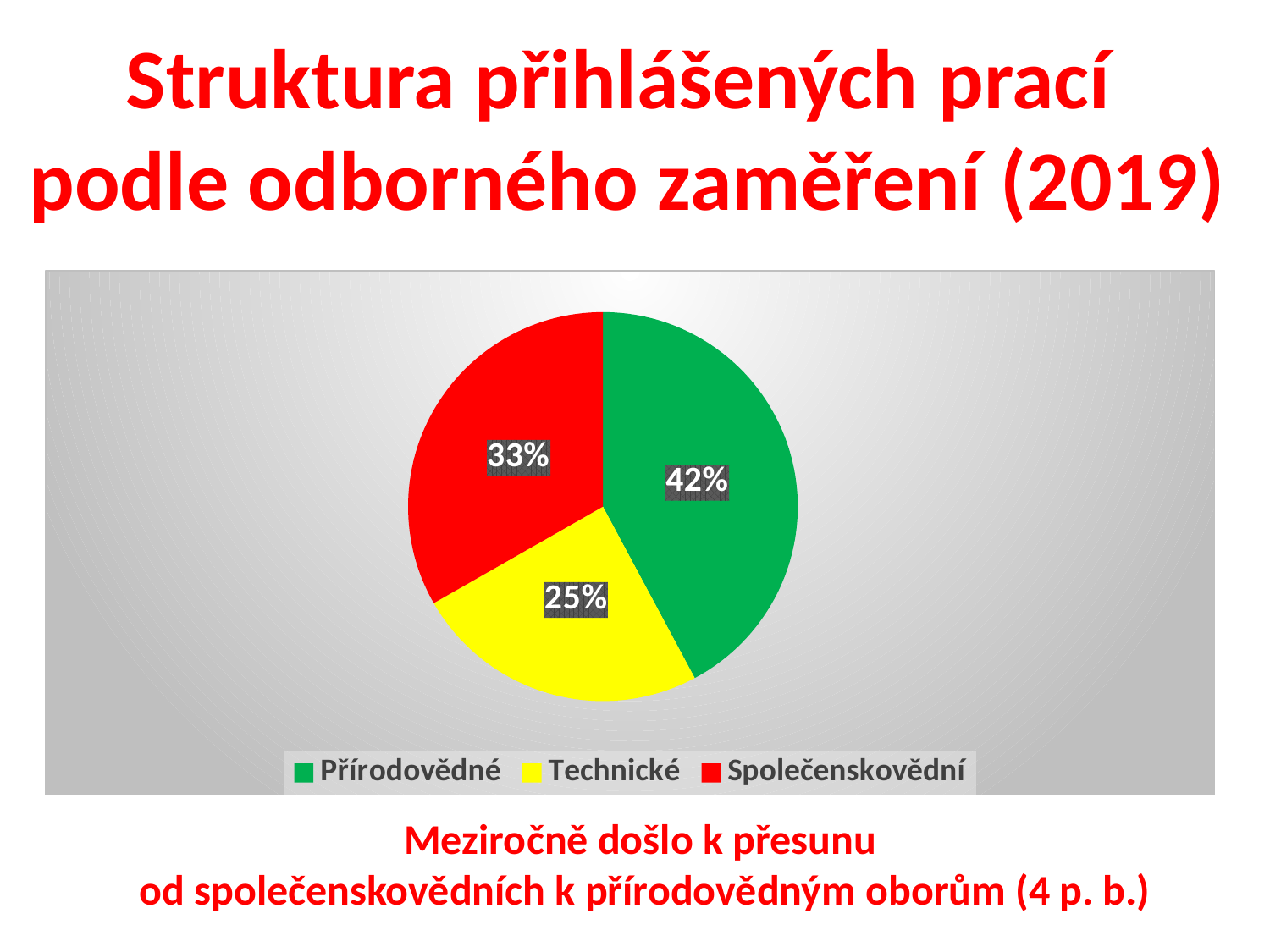
Which category is shown in green in the legend? Přírodovědné What is the difference in percentage points between the Přírodovědné and Technické slices? 17 Which is larger, the Společenskovědní slice or the Technické slice? Společenskovědní What share of the pie does Přírodovědné have? 42% How many slices does the pie chart have? 3 What share of the pie does Technické have? 25% What is the difference in percentage points between the Společenskovědní and Technické slices? 8 What colour is the Technické slice? yellow What share of the pie does Společenskovědní have? 33% Which category has the largest slice of the pie? Přírodovědné What kind of chart is shown on the slide? pie chart Which category has the smallest slice of the pie? Technické